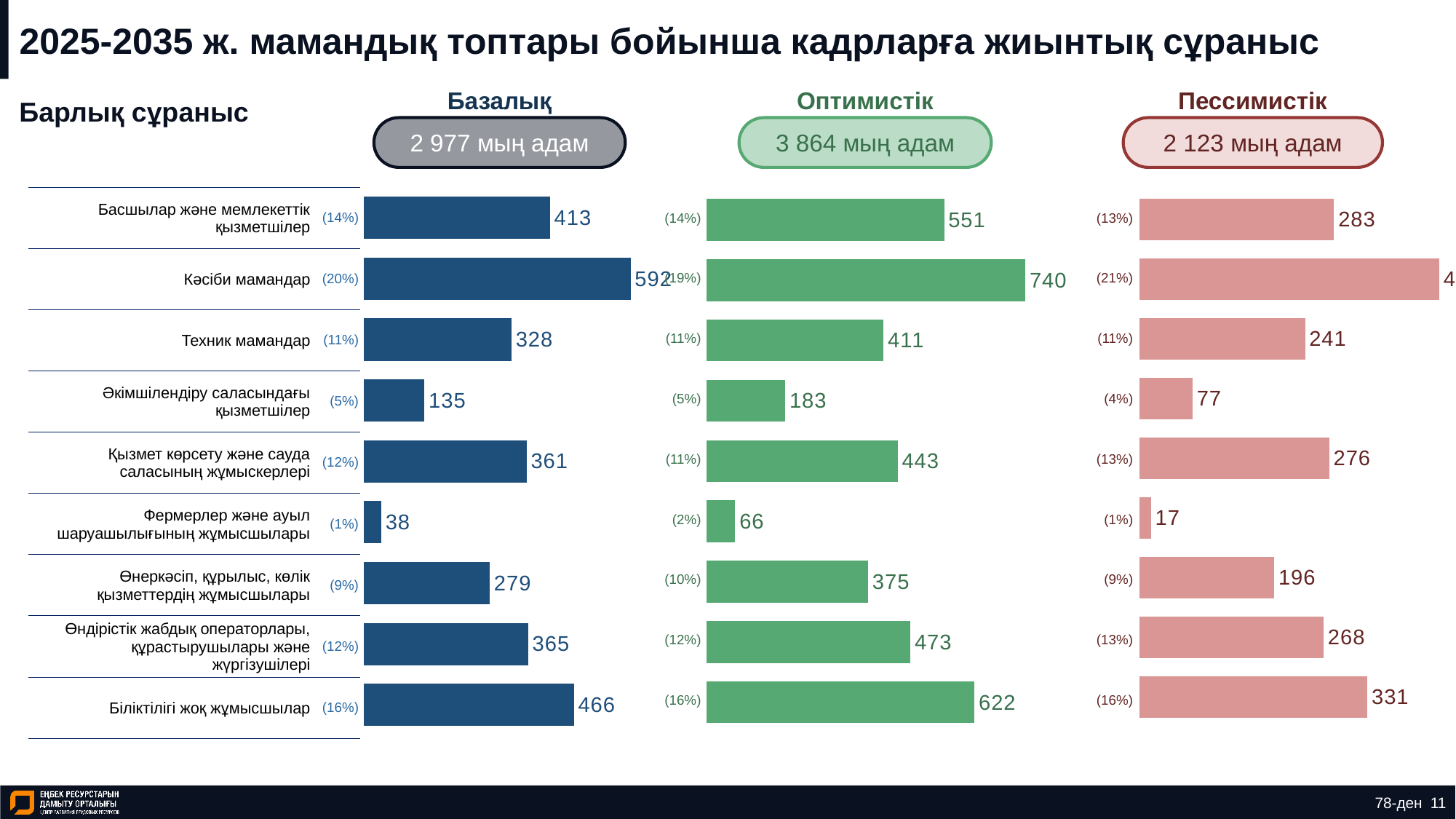
In the Оптимистік chart, what is the value for Біліктілігі жоқ жұмысшылар? 622 In the Базалық chart, what is the value for Басшылар және мемлекеттік қызметшілер? 413 In the Базалық chart, which is larger: the value for Қызмет көрсету және сауда саласының жұмыскерлері or the value for Өндірістік жабдық операторлары, құрастырушылары және жүргізушілері? Өндірістік жабдық операторлары, құрастырушылары және жүргізушілері What kind of chart is the Пессимистік chart? bar chart In the Оптимистік chart, what is the difference between the values for Кәсіби мамандар and Техник мамандар? 329 In the Оптимистік chart, which category has the highest value? Кәсіби мамандар What total is shown in the label above the Оптимистік chart? 3 864 мың адам In the Пессимистік chart, what is the value for Техник мамандар? 241 In the Пессимистік chart, which category has the lowest value? Фермерлер және ауыл шаруашылығының жұмысшылары In the Пессимистік chart, what percentage is shown next to Әкімшілендіру саласындағы қызметшілер? (4%) In the Базалық chart, which category has the lowest value? Фермерлер және ауыл шаруашылығының жұмысшылары How many categories are shown in the Базалық chart? 9